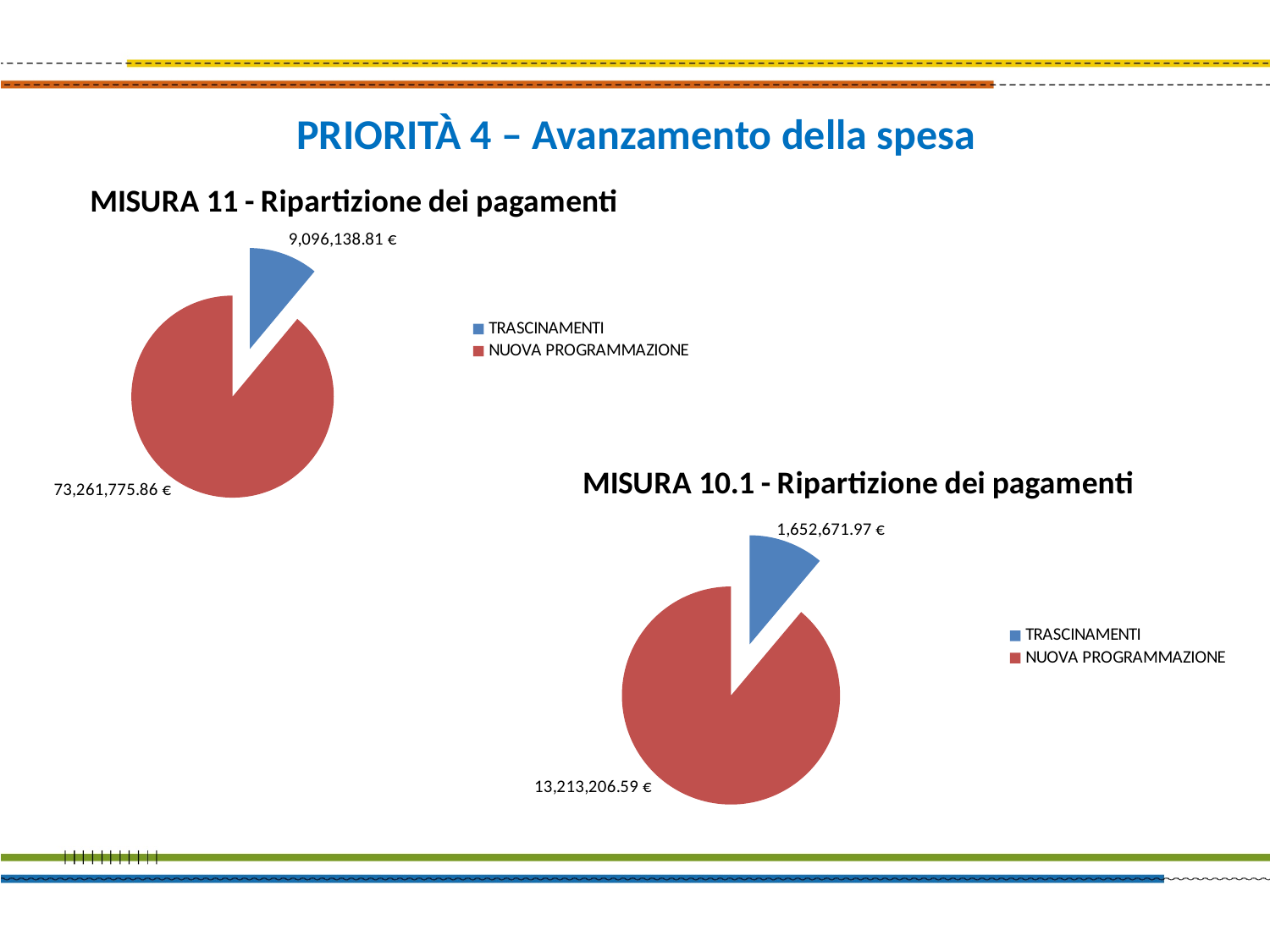
In the 'MISURA 11 - Ripartizione dei pagamenti' chart, what is the value for TRASCINAMENTI? 9,096,138.81 € In the 'MISURA 10.1 - Ripartizione dei pagamenti' chart, what is the value for NUOVA PROGRAMMAZIONE? 13,213,206.59 € In the 'MISURA 11 - Ripartizione dei pagamenti' chart, which colour represents TRASCINAMENTI? Blue In the 'MISURA 10.1 - Ripartizione dei pagamenti' chart, which category has the smallest slice? TRASCINAMENTI How many categories does the legend of the 'MISURA 10.1 - Ripartizione dei pagamenti' chart list? 2 In the 'MISURA 10.1 - Ripartizione dei pagamenti' chart, what is the difference between NUOVA PROGRAMMAZIONE and TRASCINAMENTI? 11,560,534.62 € What kind of chart is 'MISURA 11 - Ripartizione dei pagamenti'? Pie chart In the 'MISURA 11 - Ripartizione dei pagamenti' chart, what is the total of the two slices? 82,357,914.67 € In the 'MISURA 10.1 - Ripartizione dei pagamenti' chart, what is the value for TRASCINAMENTI? 1,652,671.97 € In the 'MISURA 11 - Ripartizione dei pagamenti' chart, which category has the largest slice? NUOVA PROGRAMMAZIONE In the 'MISURA 11 - Ripartizione dei pagamenti' chart, what is the value for NUOVA PROGRAMMAZIONE? 73,261,775.86 € In the 'MISURA 11 - Ripartizione dei pagamenti' chart, what is the difference between NUOVA PROGRAMMAZIONE and TRASCINAMENTI? 64,165,637.05 €